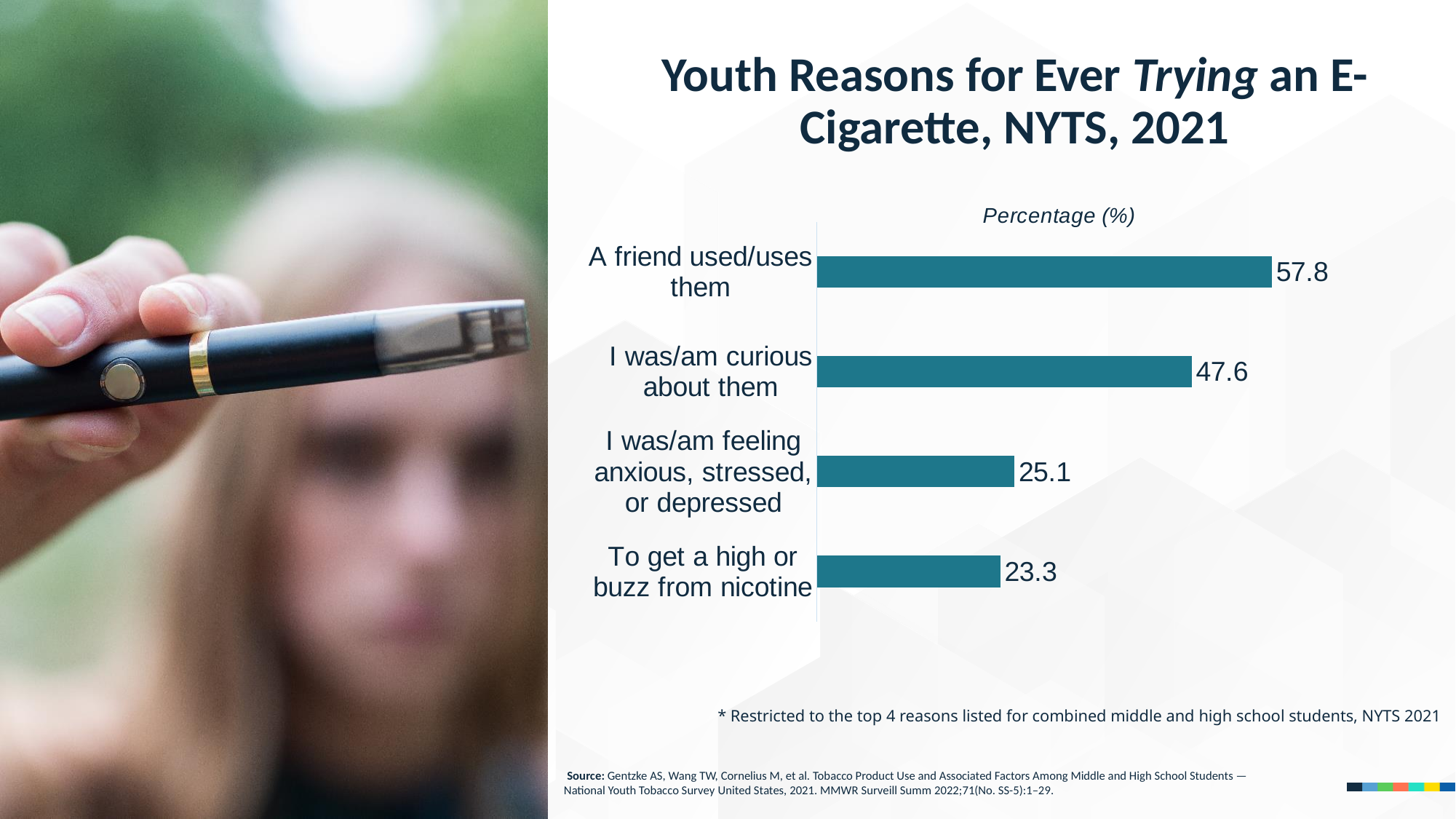
Which reason has the highest percentage? A friend used/uses them What percentage of youth gave 'A friend used/uses them' as a reason for ever trying an e-cigarette? 57.8 How many reasons are shown in the chart? 4 What is the value for 'I was/am curious about them'? 47.6 What percentage is shown for 'I was/am feeling anxious, stressed, or depressed'? 25.1 Which is larger: the value for 'I was/am curious about them' or for 'I was/am feeling anxious, stressed, or depressed'? I was/am curious about them What is the difference between the values for 'I was/am feeling anxious, stressed, or depressed' and 'To get a high or buzz from nicotine'? 1.8 What kind of chart is shown on the slide? Bar chart Which reason has the lowest percentage? To get a high or buzz from nicotine What is the difference between the values for 'A friend used/uses them' and 'I was/am curious about them'? 10.2 What is the title of the chart? Youth Reasons for Ever Trying an E-Cigarette, NYTS, 2021 What is the value for 'To get a high or buzz from nicotine'? 23.3